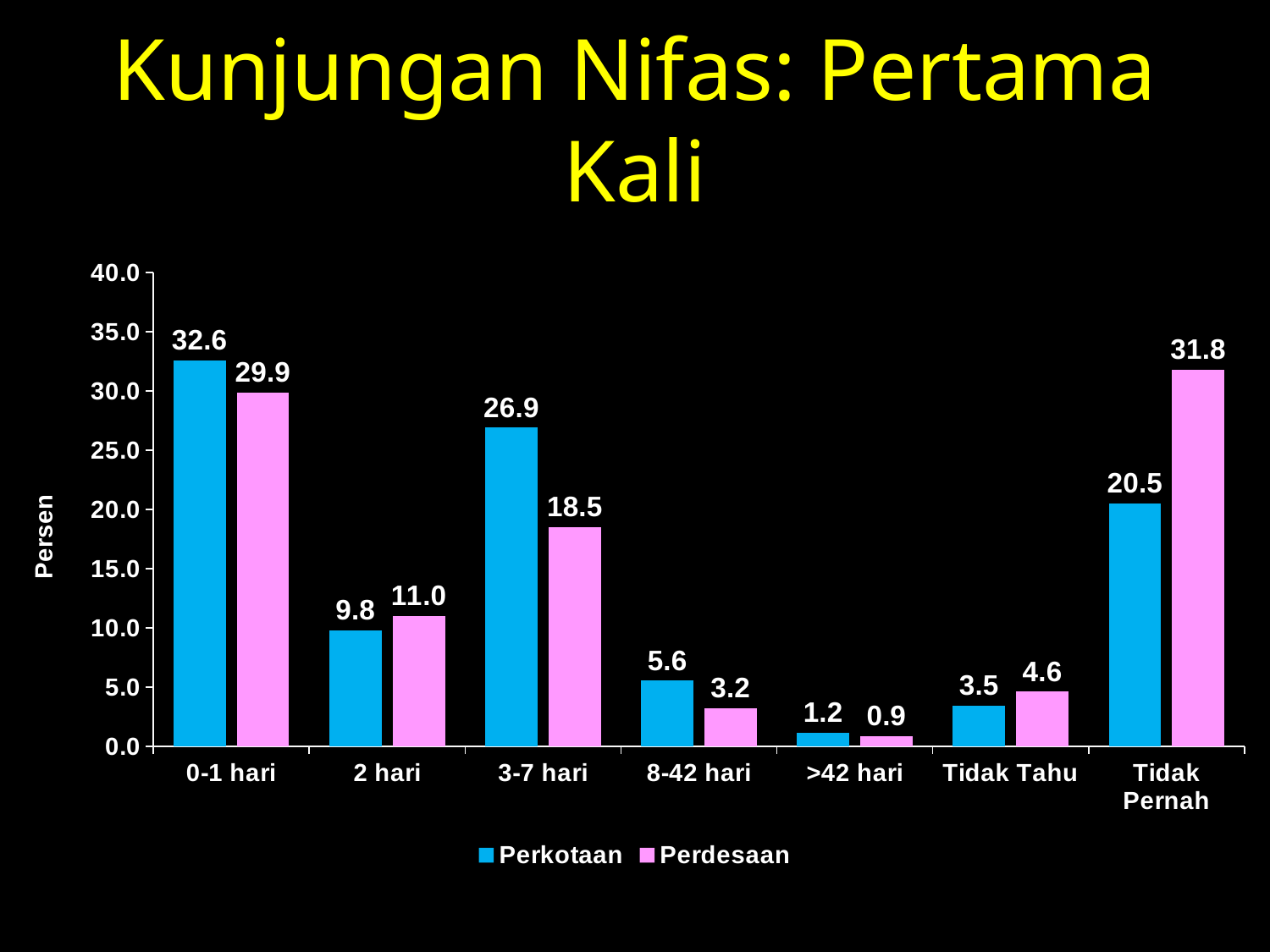
How many categories are shown on the x axis? 7 For 2 hari, which series has the larger value, Perkotaan or Perdesaan? Perdesaan What is the Perdesaan value for 3-7 hari? 18.5 Which category has the highest Perdesaan value? Tidak Pernah Is the Perkotaan value for Tidak Pernah greater or less than 25.0? less What is the Perkotaan value for 0-1 hari? 32.6 How many series does the legend list? 2 What is the difference between the Perkotaan and Perdesaan values for 3-7 hari? 8.4 What kind of chart is shown on the slide? bar chart What is the difference between the Perdesaan and Perkotaan values for Tidak Pernah? 11.3 Which category has the lowest Perkotaan value? >42 hari What is the Perdesaan value for Tidak Pernah? 31.8